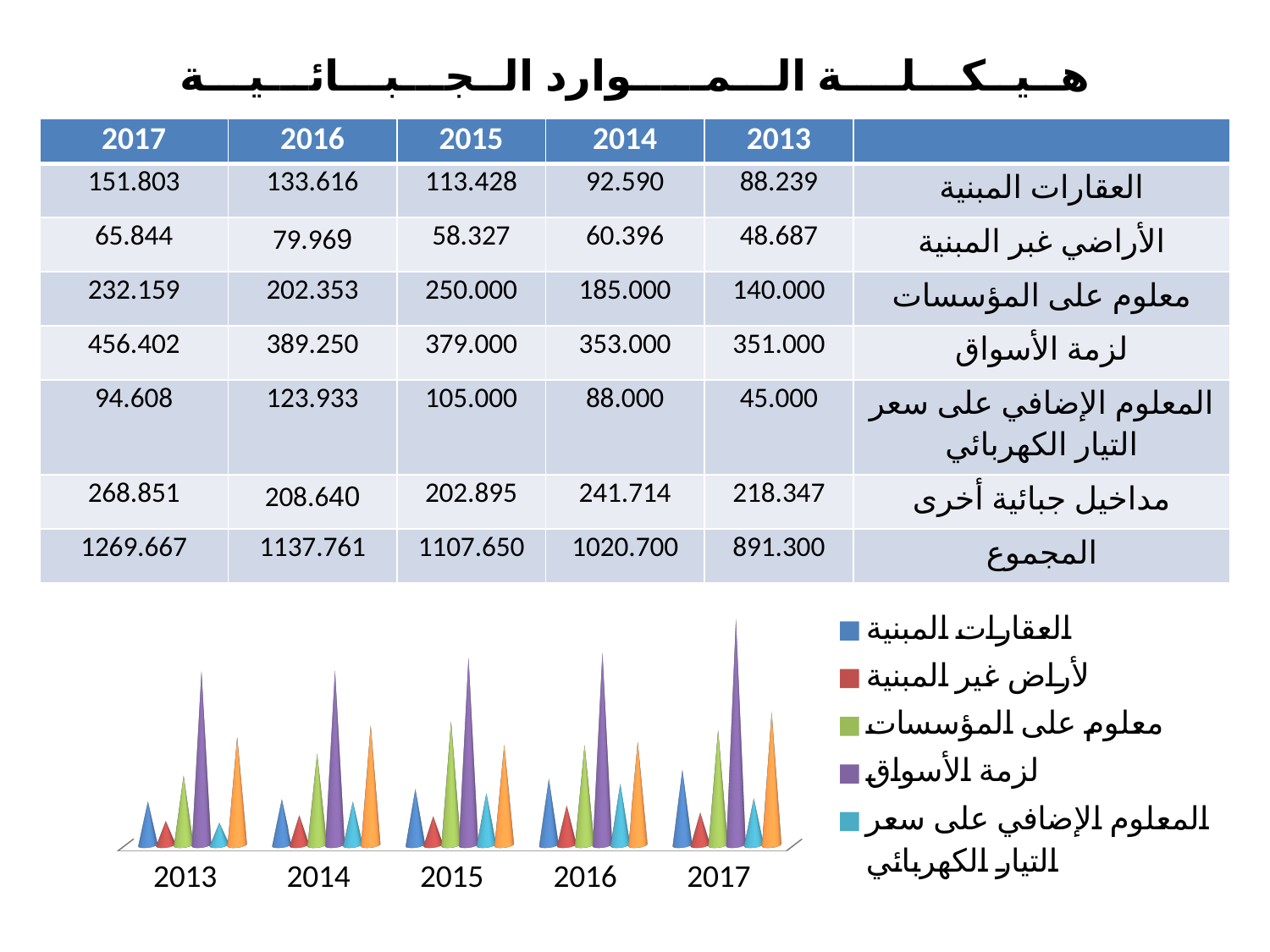
How many series does the chart legend list? 5 What is the value of معلوم على المؤسسات in 2015 according to the table? 250.000 What is the difference between the لزمة الأسواق values for 2017 and 2016 in the table? 67.152 Do the bars for العقارات المبنية rise or fall from 2013 to 2017? rise Do the bars for لزمة الأسواق rise or fall from 2013 to 2017? rise Which series has the tallest bar in 2013? لزمة الأسواق What is the value of لزمة الأسواق in 2017 according to the table? 456.402 What kind of chart is shown at the bottom of the slide? bar chart How many years (categories) are shown on the x axis of the chart? 5 In 2017, which is taller: the bar for الأراضي غير المبنية or the bar for المعلوم الإضافي على سعر التيار الكهربائي? المعلوم الإضافي على سعر التيار الكهربائي In 2015, which is taller: the bar for معلوم على المؤسسات or the bar for مداخيل جبائية أخرى? معلوم على المؤسسات Which series has the tallest bar in 2017? لزمة الأسواق